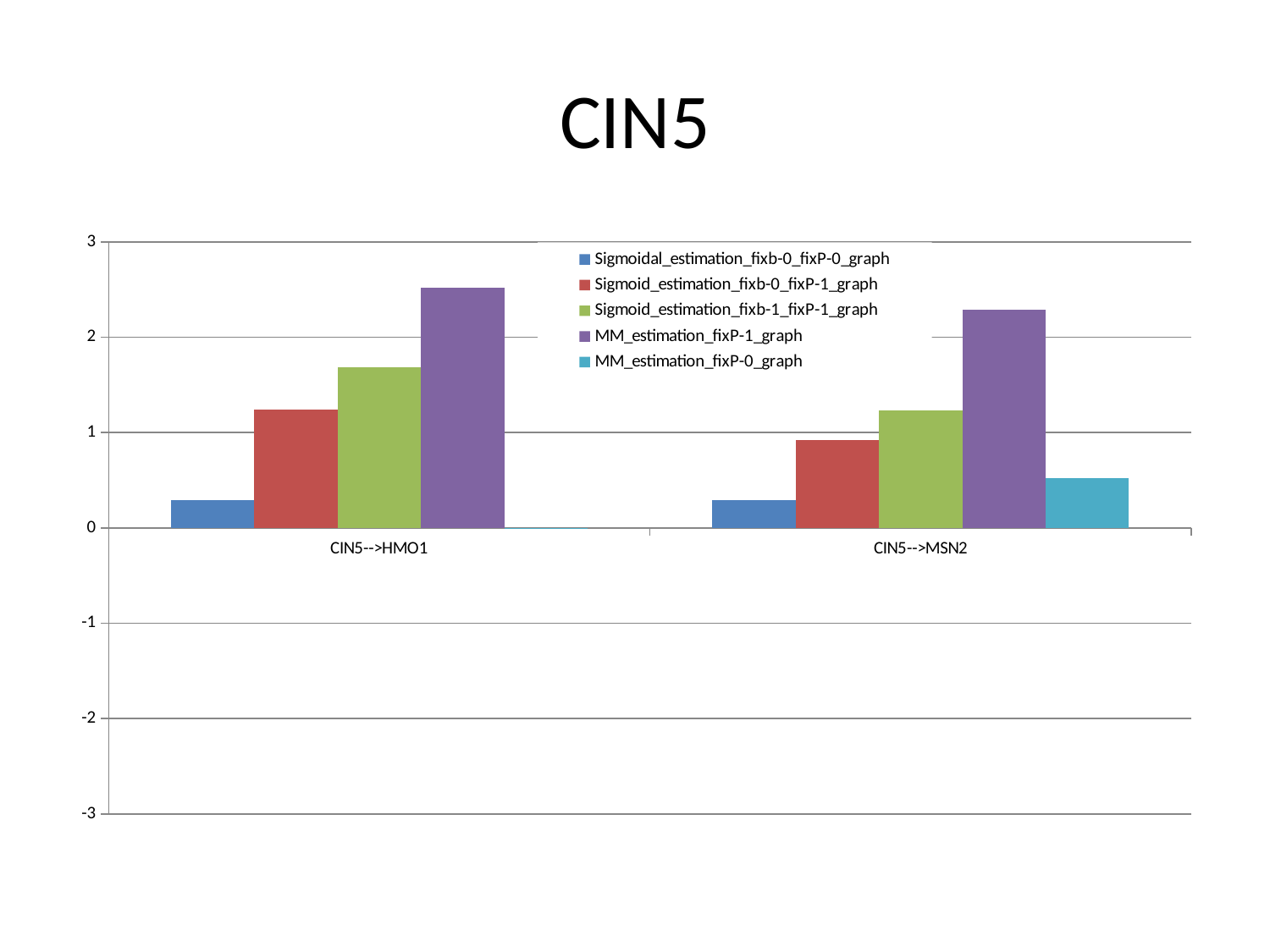
Which series has the highest value for CIN5-->MSN2? MM_estimation_fixP-1_graph How many categories are shown on the x axis? 2 Which series has the lowest value for CIN5-->MSN2? Sigmoidal_estimation_fixb-0_fixP-0_graph What is the title of the slide? CIN5 How many series does the legend list? 5 Is the value of Sigmoid_estimation_fixb-0_fixP-1_graph for CIN5-->MSN2 greater or less than 1? less Which series has the highest value for CIN5-->HMO1? MM_estimation_fixP-1_graph Which is larger: the Sigmoid_estimation_fixb-1_fixP-1_graph value for CIN5-->HMO1 or for CIN5-->MSN2? CIN5-->HMO1 Is the value of MM_estimation_fixP-1_graph for CIN5-->HMO1 greater or less than 2? greater What kind of chart is shown on the slide? bar chart Which is larger: the MM_estimation_fixP-0_graph value for CIN5-->HMO1 or for CIN5-->MSN2? CIN5-->MSN2 Which series has the lowest value for CIN5-->HMO1? MM_estimation_fixP-0_graph